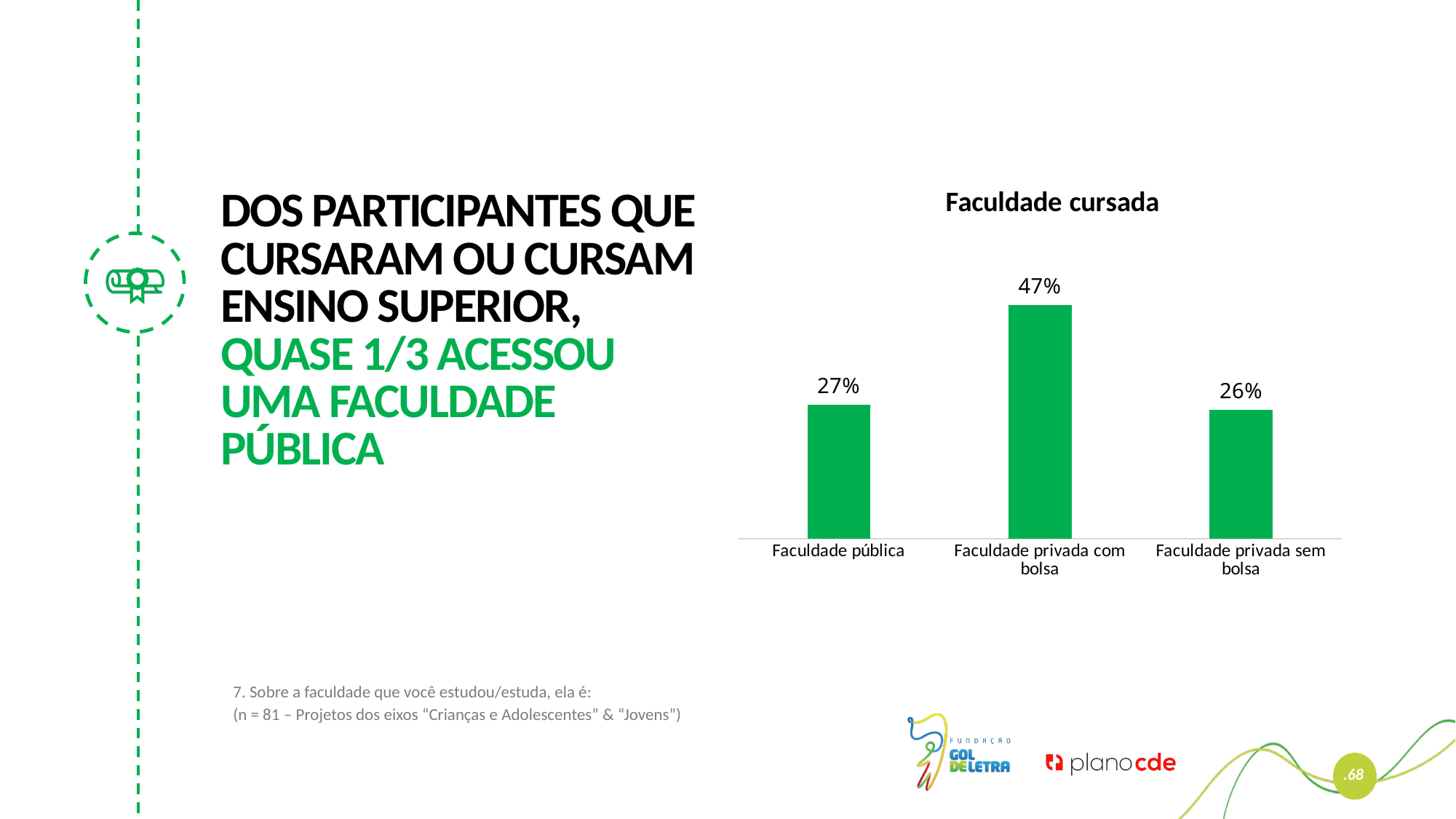
How many categories are shown in the chart? 3 Which category has the highest value? Faculdade privada com bolsa What is the difference between Faculdade pública and Faculdade privada sem bolsa? 1% What is the value for Faculdade privada com bolsa? 47% What is the difference between Faculdade privada com bolsa and Faculdade pública? 20% Which is larger, Faculdade privada com bolsa or Faculdade privada sem bolsa? Faculdade privada com bolsa What is the value for Faculdade pública? 27% What colour are the bars in the chart? Green What is the value for Faculdade privada sem bolsa? 26% Which category has the lowest value? Faculdade privada sem bolsa What kind of chart is shown on the slide? Bar chart What is the title of the chart? Faculdade cursada